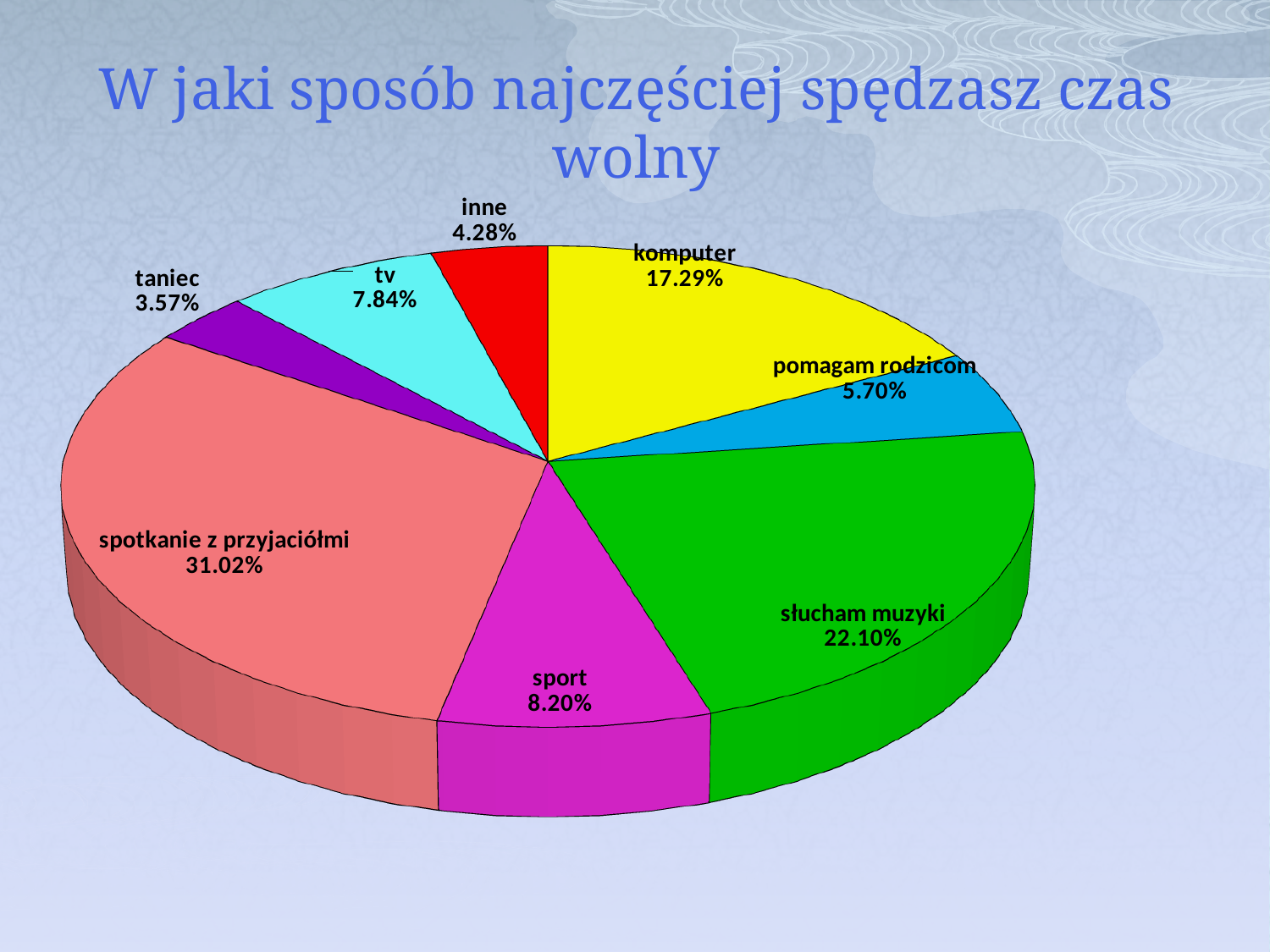
Which category has the largest slice of the pie? spotkanie z przyjaciółmi What is the value shown for "inne"? 4.28% What is the title of the chart on the slide? W jaki sposób najczęściej spędzasz czas wolny What kind of chart is shown on the slide? pie chart What share of the pie does "spotkanie z przyjaciółmi" have? 31.02% What colour is the slice for "słucham muzyki"? green What is the value shown for "pomagam rodzicom"? 5.70% How many categories are shown in the pie chart? 8 Which category has the smallest slice of the pie? taniec What is the value shown for "komputer"? 17.29% What is the difference between the values for "słucham muzyki" and "komputer"? 4.81% Which is larger, the value for "sport" or the value for "tv"? sport